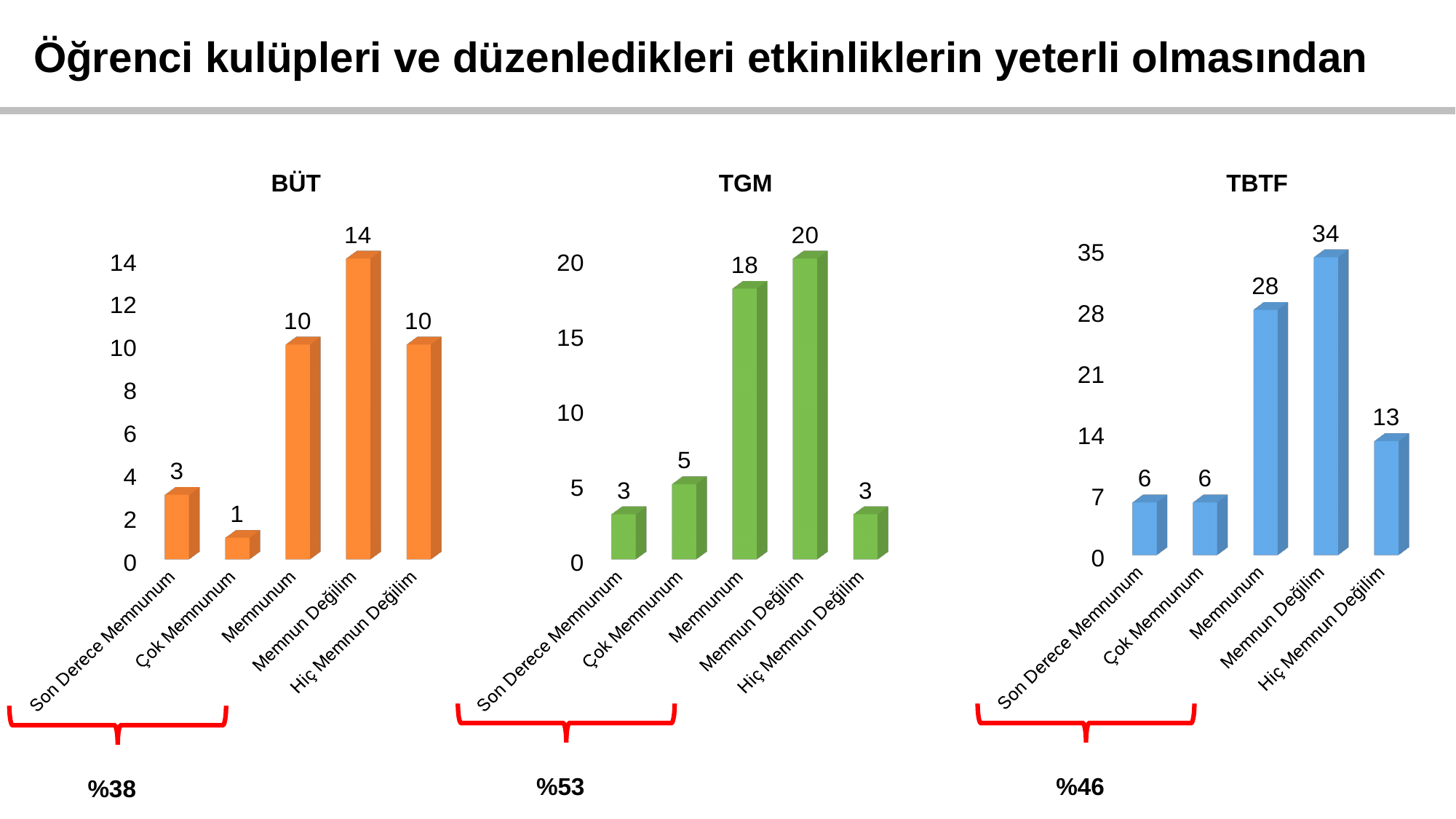
In the TBTF chart, which category has the highest value? Memnun Değilim What kind of chart is the TGM chart? bar chart In the TGM chart, what is the value for Memnunum? 18 What colour are the bars in the TBTF chart? blue In the TGM chart, which is larger: Memnunum or Hiç Memnun Değilim? Memnunum How many categories does the BÜT chart show? 5 In the TBTF chart, what is the difference between Memnun Değilim and Memnunum? 6 In the TGM chart, what is the difference between Memnun Değilim and Çok Memnunum? 15 In the BÜT chart, which category has the lowest value? Çok Memnunum In the TBTF chart, what is the value for Hiç Memnun Değilim? 13 In the BÜT chart, is the value for Memnunum greater or less than 8? greater In the BÜT chart, what is the value for Memnun Değilim? 14